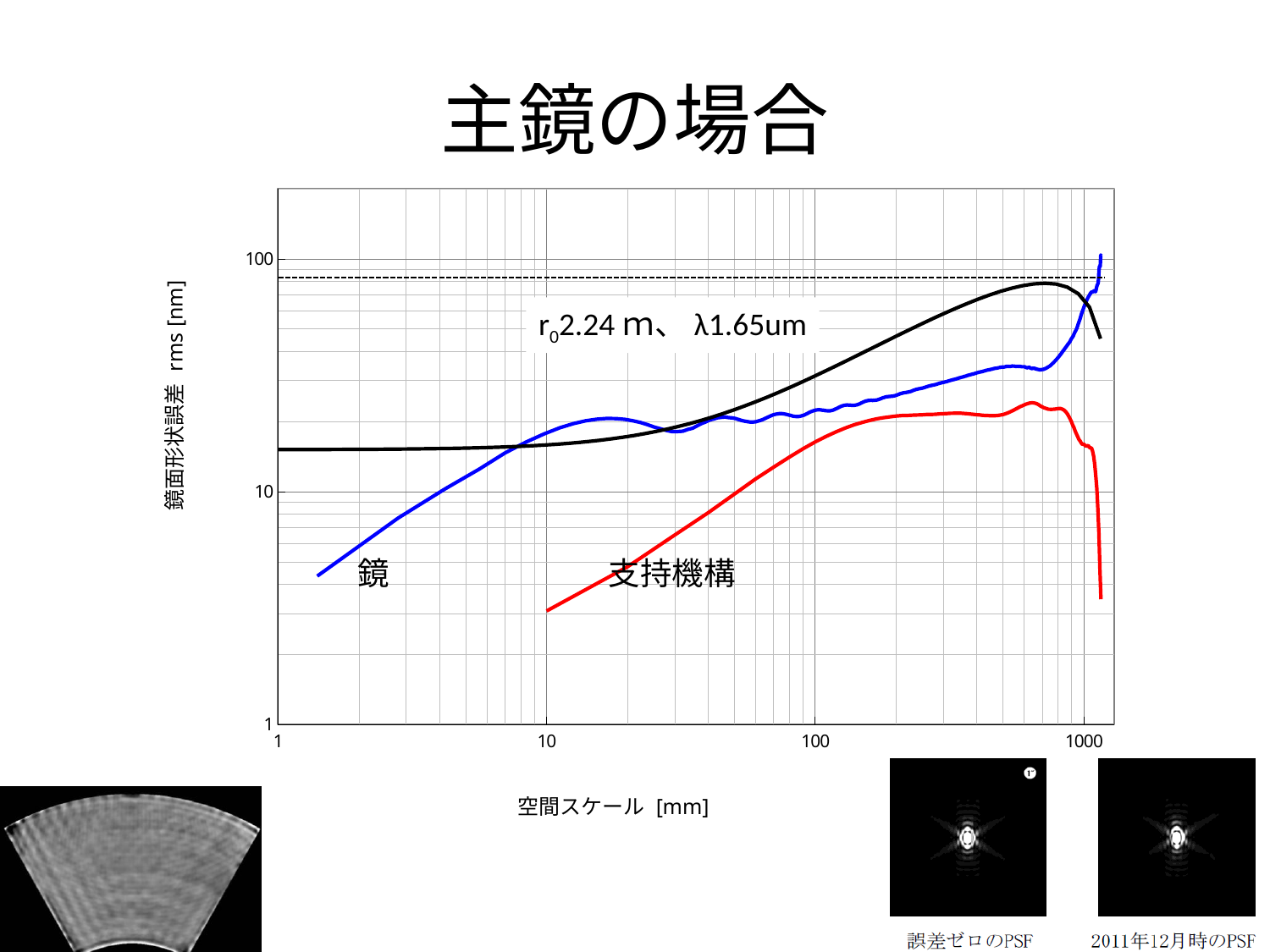
At a spatial scale of 10 mm, which curve is higher: 鏡 (blue) or 支持機構 (red)? 鏡 (blue) What kind of chart is shown on the slide? line chart Does the 鏡 (blue) curve rise or fall between spatial scales of 1 mm and 10 mm? rise Is the value of the 鏡 (blue) curve at a spatial scale of 100 mm greater or less than 100? less How many curves are plotted on the chart? 3 At a spatial scale of 100 mm, which curve is higher: the black curve or the 支持機構 (red) curve? the black curve What is the title of the slide containing the chart? 主鏡の場合 What is the label of the x axis of the chart? 空間スケール [mm] Is the value of the 支持機構 (red) curve at a spatial scale of 10 mm greater or less than 10? less Does the 支持機構 (red) curve rise or fall between spatial scales of 10 mm and 100 mm? rise Is the value of the black curve at a spatial scale of 1 mm greater or less than 10? greater